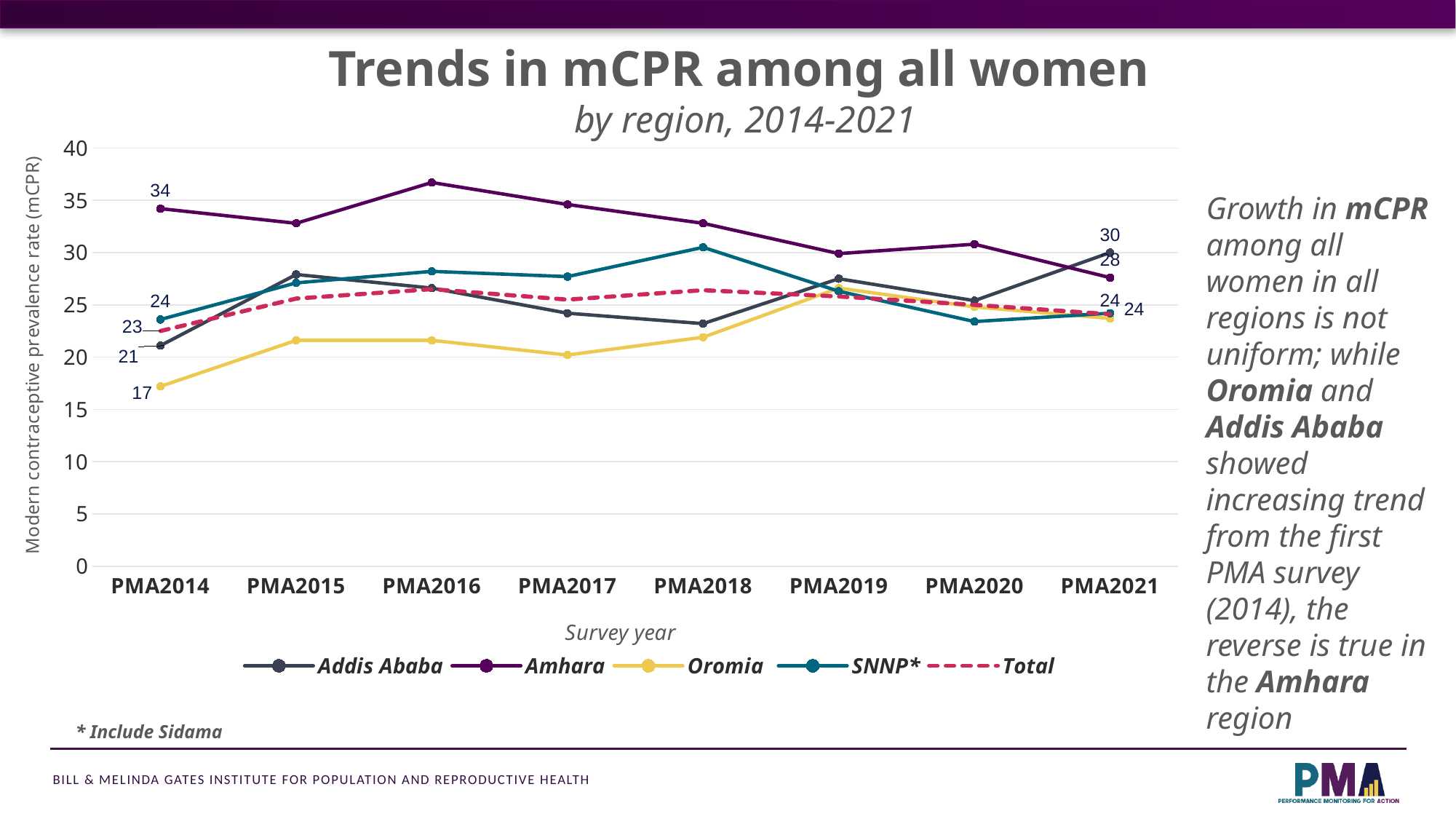
What is the mCPR value for Oromia at PMA2014? 17 Is the value for Amhara at PMA2016 greater or less than 35? greater What is the mCPR value for Amhara at PMA2014? 34 What is the difference between the Amhara and Oromia values at PMA2014? 17 What is the mCPR value for Addis Ababa at PMA2021? 30 How many series does the legend list? 5 Which is larger at PMA2021, the value for Addis Ababa or the value for Amhara? Addis Ababa What is the mCPR value for Amhara at PMA2021? 28 Which region has the lowest mCPR at PMA2014? Oromia What kind of chart is shown on the slide? Line chart How many survey years are shown on the x axis? 8 Which region has the highest mCPR at PMA2014? Amhara